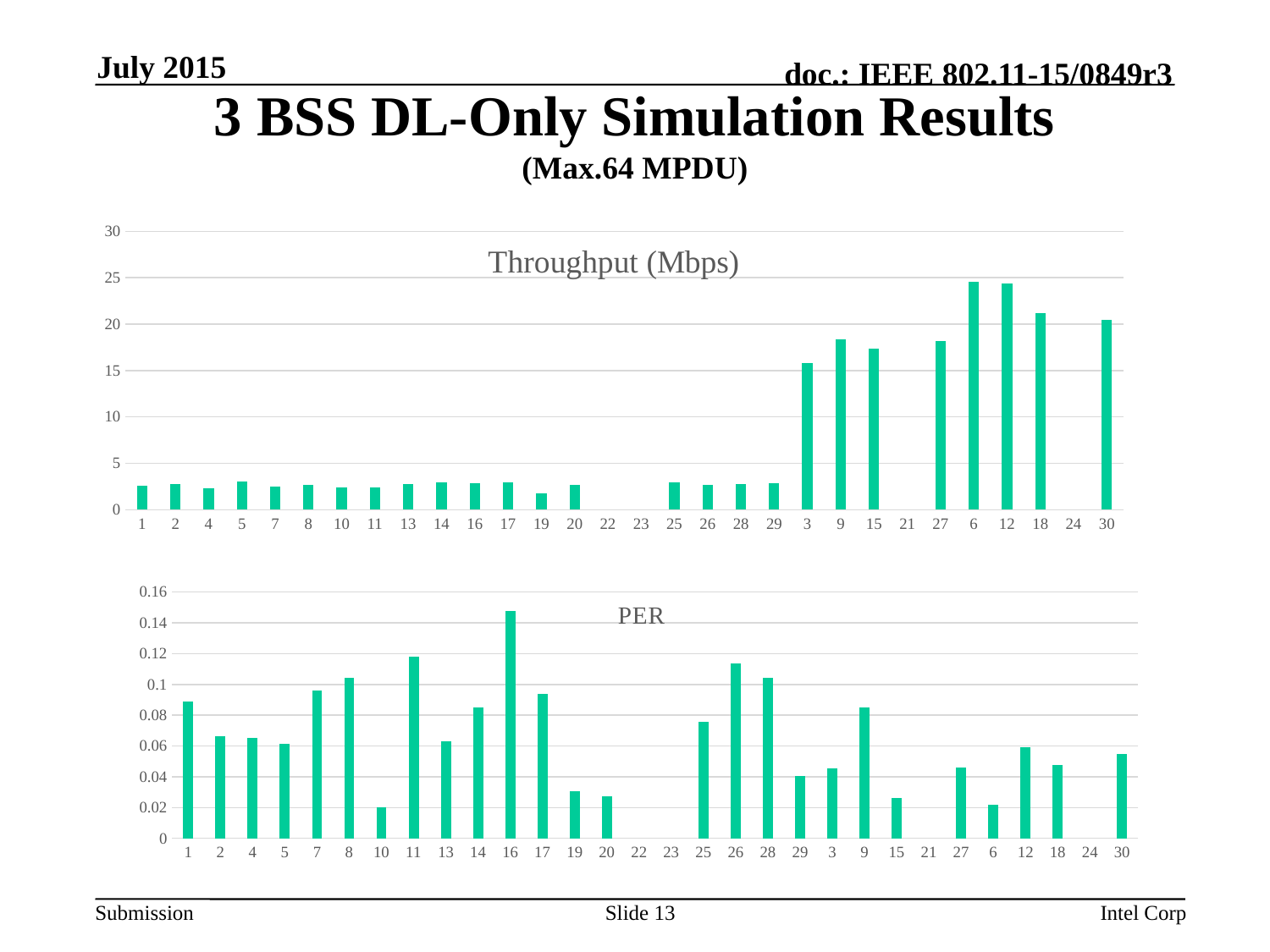
In the PER chart, which category has the highest PER? 16 In the PER chart, which has the larger value, category 2 or category 10? 2 What kind of chart is the Throughput (Mbps) chart? bar chart What kind of chart is the PER chart? bar chart In the Throughput (Mbps) chart, which has the larger value, category 6 or category 30? 6 In the Throughput (Mbps) chart, is the value for category 1 greater or less than 5? less In the PER chart, is the value for category 19 greater or less than 0.04? less What is the title of the upper chart on the slide? Throughput (Mbps) In the Throughput (Mbps) chart, is the value for category 9 greater or less than 15? greater How many categories are shown on the x axis of the Throughput (Mbps) chart? 30